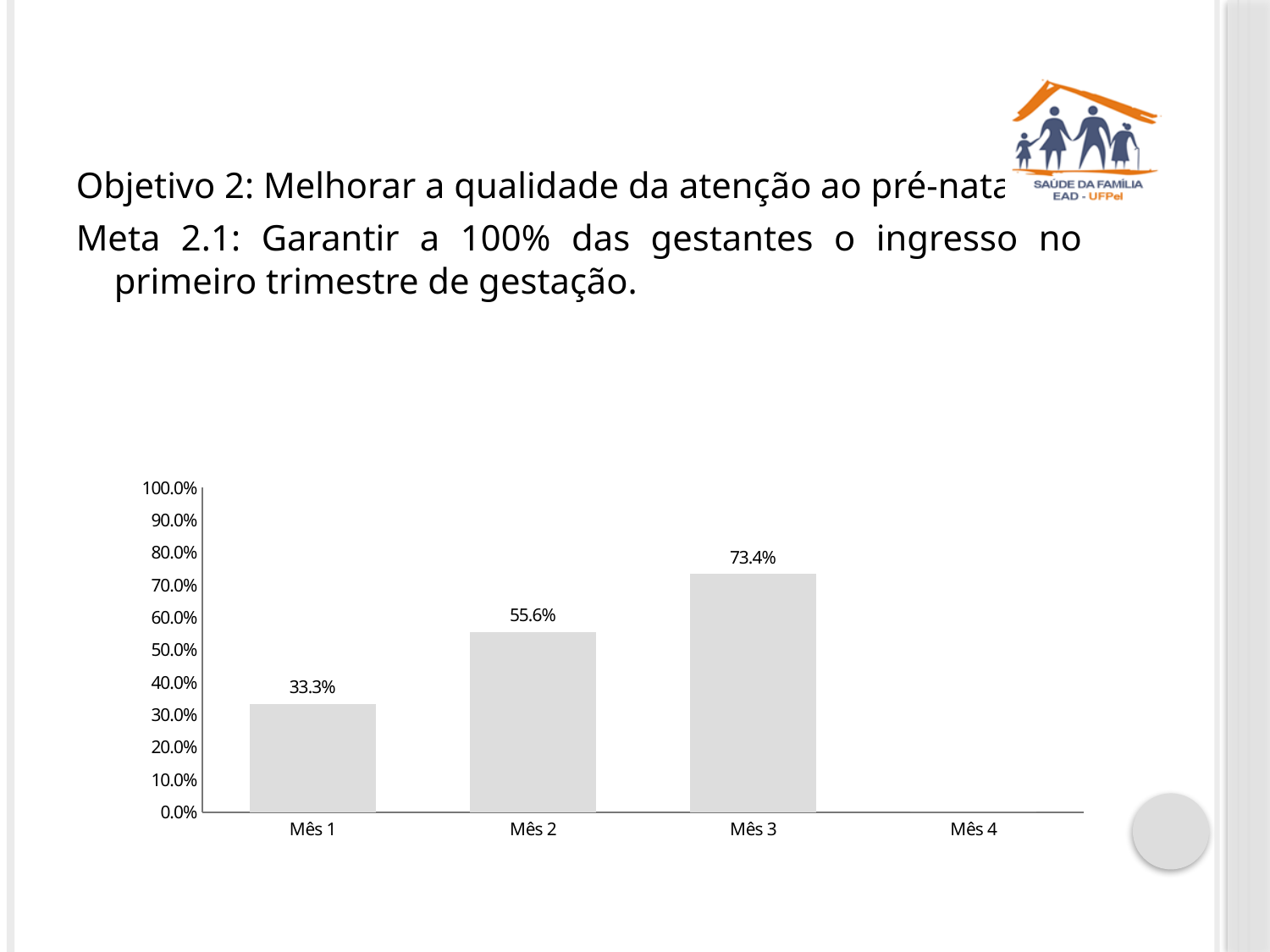
What is the value for Mês 2? 55.6% What is the difference between the values for Mês 2 and Mês 1? 22.3% What is the difference between the values for Mês 3 and Mês 1? 40.1% Among the months with a plotted bar, which has the lowest value? Mês 1 Is the value for Mês 2 greater or less than 50.0%? greater Which is larger, the value for Mês 2 or the value for Mês 3? Mês 3 How many categories are shown on the x axis? 4 What is the value for Mês 1? 33.3% What kind of chart is shown on the slide? Bar chart Which month has the highest value? Mês 3 Do the values rise or fall from Mês 1 to Mês 3? Rise What is the value for Mês 3? 73.4%